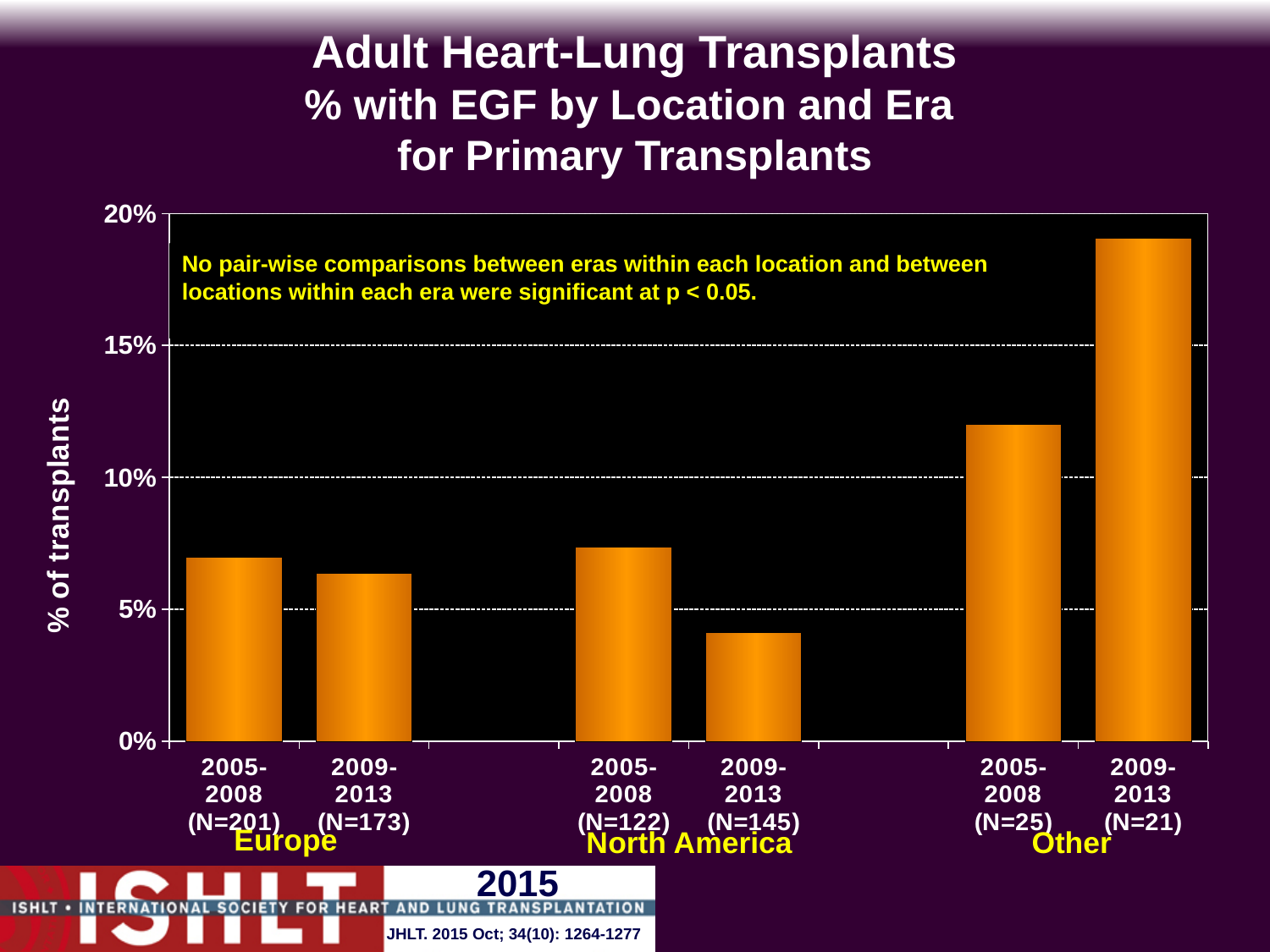
What kind of chart is shown on the slide? bar chart Which location and era has the lowest % of transplants with EGF? North America, 2009-2013 For North America, does the % with EGF rise or fall from 2005-2008 to 2009-2013? fall Is the value for Other 2005-2008 greater or less than 10%? greater Is the value for Other 2009-2013 greater or less than 15%? greater What is the N for the Europe 2005-2008 bar? N=201 Which is larger: the value for Other 2005-2008 or the value for Europe 2005-2008? Other 2005-2008 Is the value for Europe 2005-2008 greater or less than 10%? less Which location and era has the highest % of transplants with EGF? Other, 2009-2013 What is the label on the y axis of the chart? % of transplants How many bars are plotted in the chart? 6